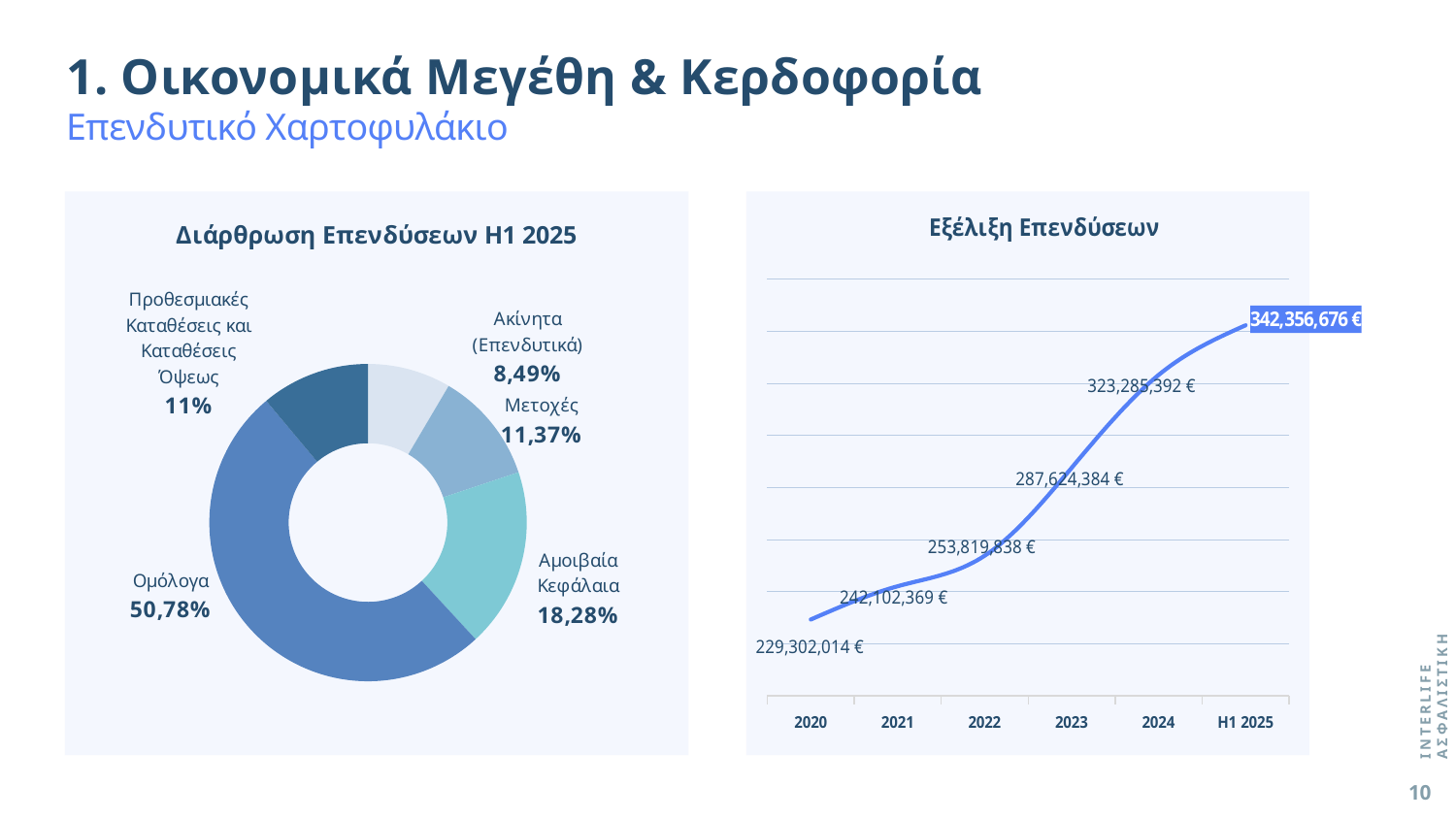
In the chart titled 'Εξέλιξη Επενδύσεων', do the values rise or fall from 2020 to H1 2025? Rise In the chart titled 'Διάρθρωση Επενδύσεων H1 2025', what share do Ομόλογα represent? 50,78% In the chart titled 'Διάρθρωση Επενδύσεων H1 2025', which is larger: Μετοχές or Αμοιβαία Κεφάλαια? Αμοιβαία Κεφάλαια In the chart titled 'Διάρθρωση Επενδύσεων H1 2025', what is the percentage for Αμοιβαία Κεφάλαια? 18,28% In the chart titled 'Διάρθρωση Επενδύσεων H1 2025', which category has the largest share? Ομόλογα In the chart titled 'Εξέλιξη Επενδύσεων', what is the value for H1 2025? 342,356,676 € In the chart titled 'Εξέλιξη Επενδύσεων', what is the difference between the H1 2025 value and the 2024 value? 19,071,284 € In the chart titled 'Εξέλιξη Επενδύσεων', what is the value for 2022? 253,819,838 € In the chart titled 'Διάρθρωση Επενδύσεων H1 2025', how many categories are shown? 5 In the chart titled 'Διάρθρωση Επενδύσεων H1 2025', which category has the smallest share? Ακίνητα (Επενδυτικά) In the chart titled 'Εξέλιξη Επενδύσεων', how many data points are plotted? 6 What type of chart is the one titled 'Διάρθρωση Επενδύσεων H1 2025'? Donut (pie) chart